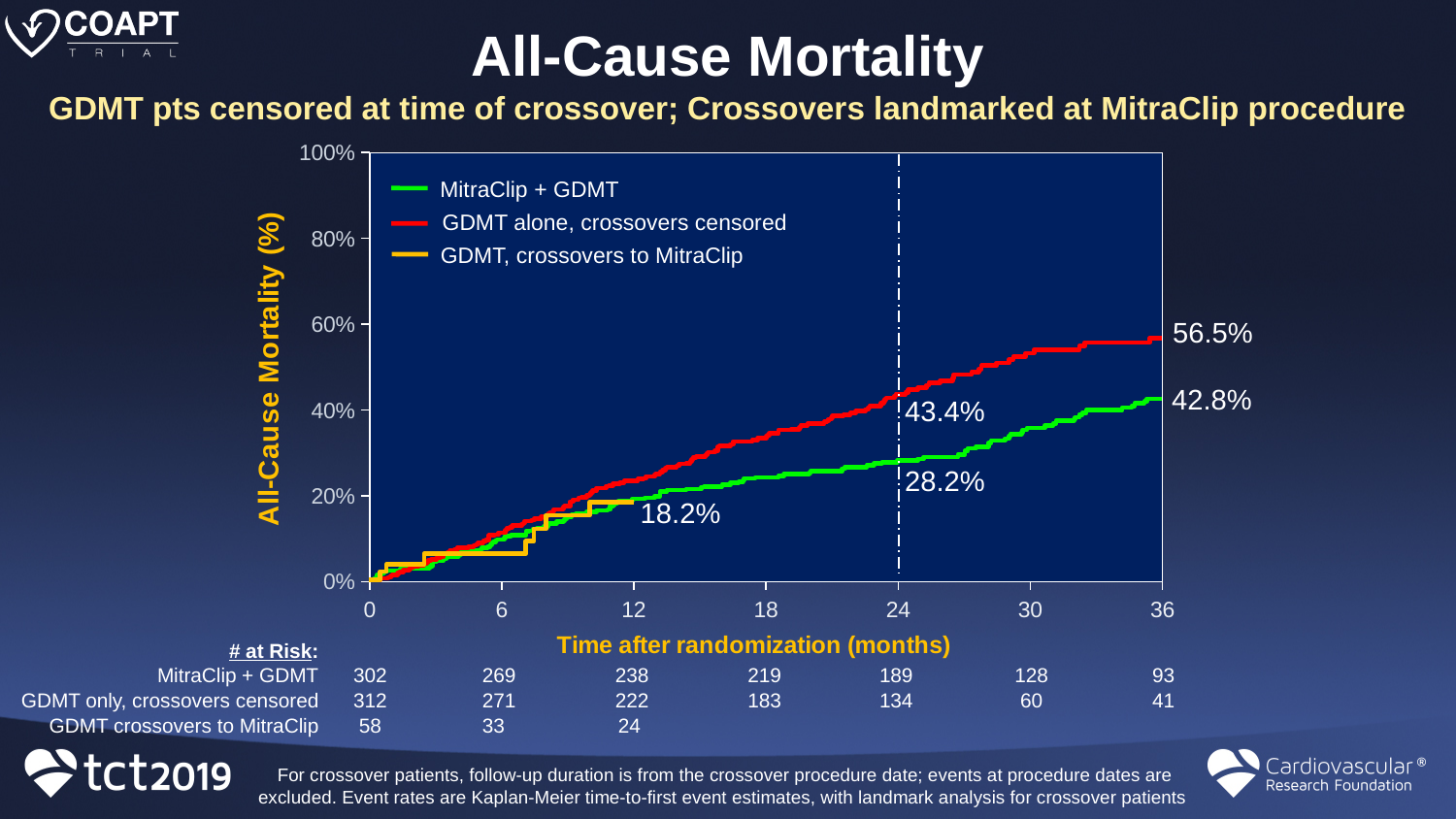
What is the title of the y axis? All-Cause Mortality (%) What is the all-cause mortality for GDMT alone, crossovers censored at 24 months? 43.4% How many series does the legend list? 3 Do the mortality curves rise or fall as time after randomization increases? rise Which series has the higher all-cause mortality at 36 months, MitraClip + GDMT or GDMT alone, crossovers censored? GDMT alone, crossovers censored What is the all-cause mortality for GDMT alone, crossovers censored at 36 months? 56.5% What is the difference in all-cause mortality between GDMT alone, crossovers censored and MitraClip + GDMT at 24 months? 15.2 percentage points What is the all-cause mortality for MitraClip + GDMT at 24 months? 28.2% What is the difference in all-cause mortality between GDMT alone, crossovers censored and MitraClip + GDMT at 36 months? 13.7 percentage points What kind of chart is shown on the slide? line chart What is the all-cause mortality for MitraClip + GDMT at 36 months? 42.8% Is the all-cause mortality for MitraClip + GDMT at 30 months greater or less than 40%? less